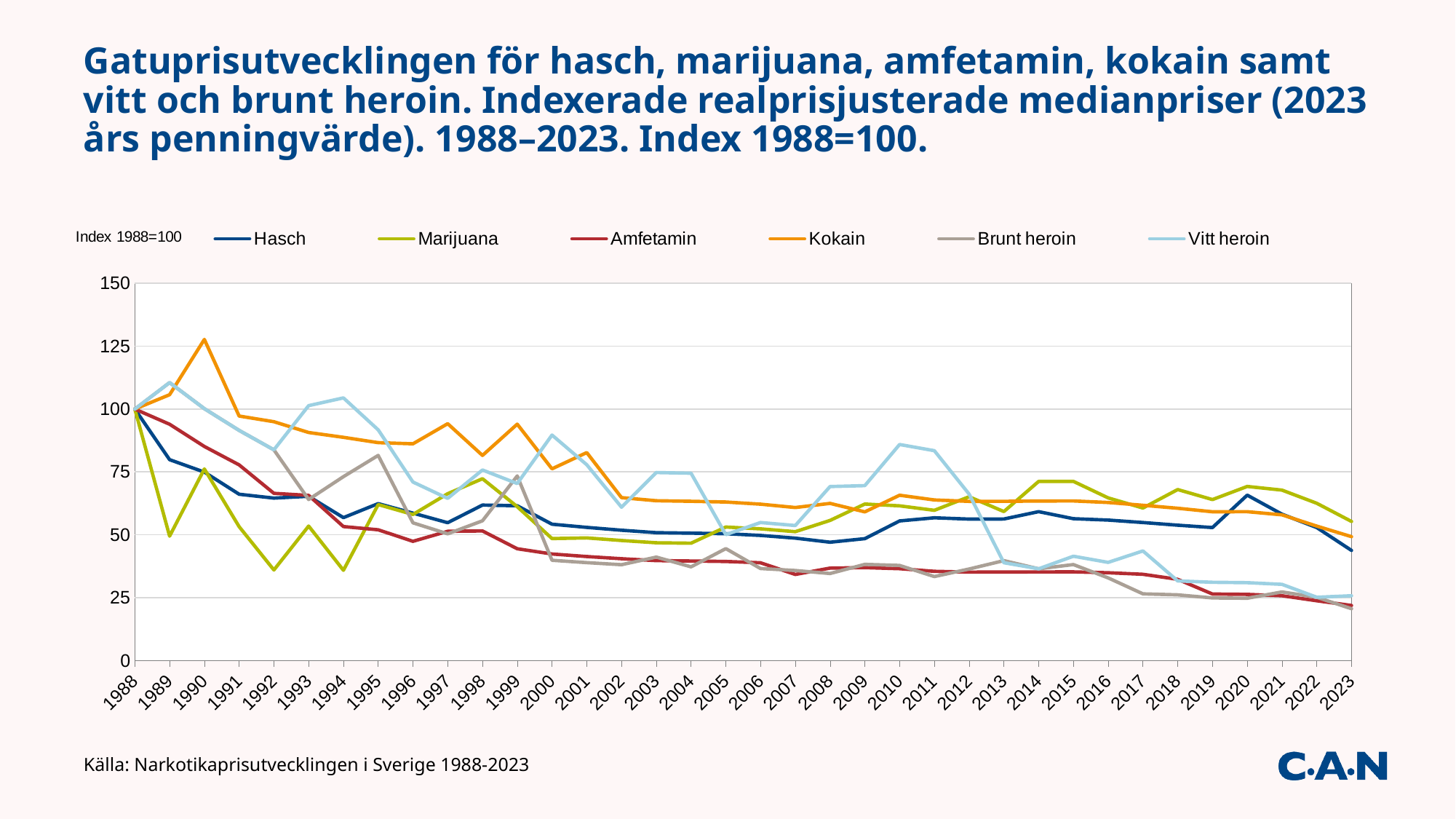
Does the Hasch series generally rise or fall from 1988 to 2023? fall In 2010, which is larger: the value for Vitt heroin or the value for Hasch? Vitt heroin How many series does the legend list? 6 What is the index value for Hasch in 1988? 100 Is the value for Brunt heroin in 2017 greater or less than 50? less Is the value for Vitt heroin in 2010 greater or less than 75? greater Which series has the lowest value in 1992? Marijuana Is the value for Kokain in 1990 greater or less than 100? greater What kind of chart is shown on the slide? line chart How many years are plotted along the x axis? 36 Which series is drawn in orange? Kokain Which series has the highest value in 1990? Kokain